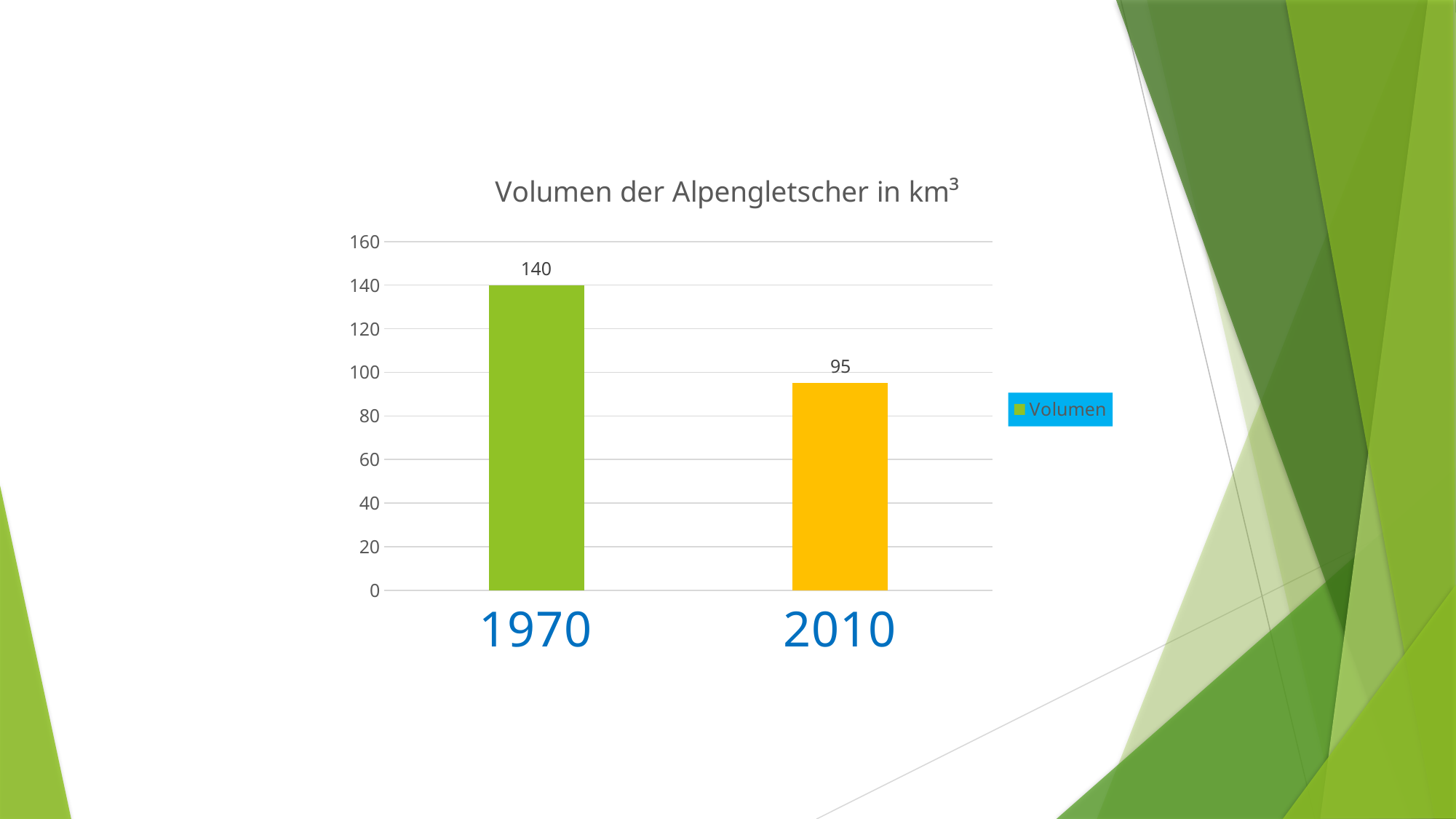
What is the value for 1970? 140 Which is larger, the value for 1970 or the value for 2010? 1970 What is the difference between the values for 1970 and 2010? 45 Do the values rise or fall from 1970 to 2010? fall Is the value for 1970 greater or less than 120? greater Which year has the highest value? 1970 Is the value for 2010 greater or less than 100? less How many series does the legend list? 1 Which year has the lowest value? 2010 What kind of chart is shown? bar chart How many categories are shown on the x axis? 2 What is the value for 2010? 95